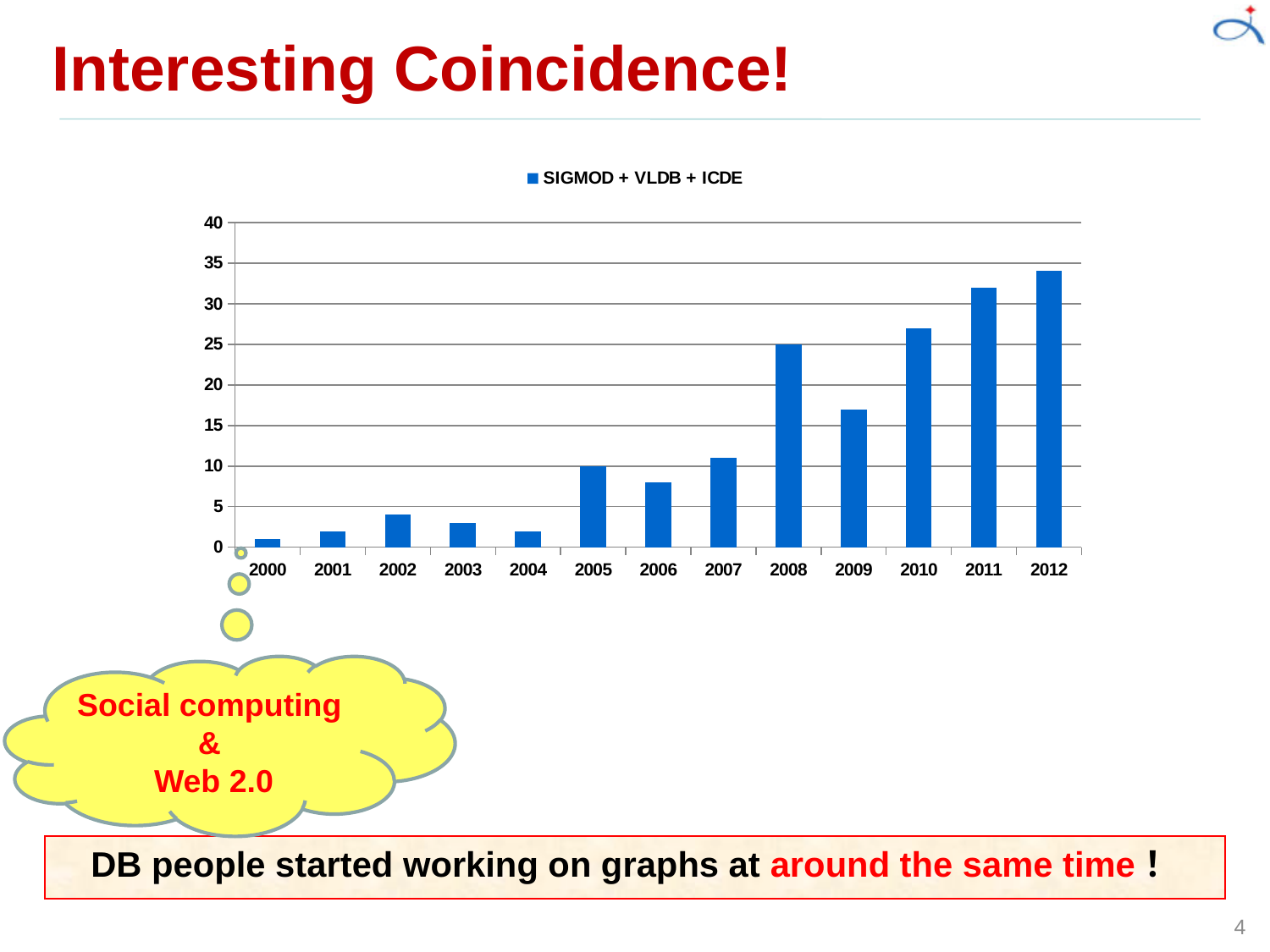
How many years (categories) are plotted on the x axis? 13 Is the value for 2006 greater or less than 10? less Overall, do the values rise or fall from 2000 to 2012? rise What is the name of the series shown in the chart legend? SIGMOD + VLDB + ICDE Which year has the highest bar? 2012 Which year has the lowest bar? 2000 Is the value for 2009 greater or less than 20? less What kind of chart is shown on the slide? bar chart Is the value for 2002 greater or less than 5? less How many series does the chart legend list? 1 Which year has the larger value, 2008 or 2009? 2008